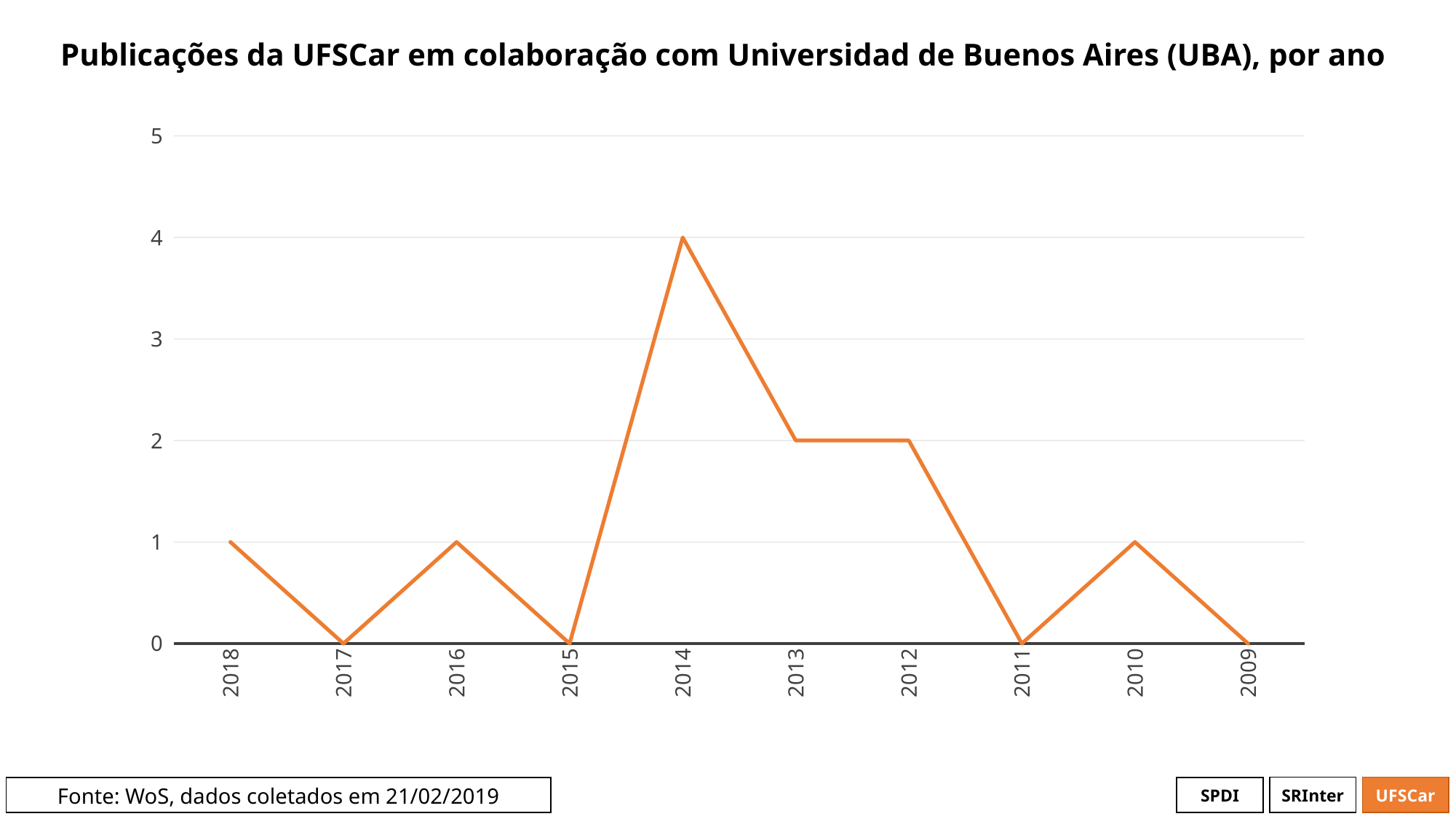
Which year has the highest value? 2014 What is the title of the chart? Publicações da UFSCar em colaboração com Universidad de Buenos Aires (UBA), por ano What is the value for 2014? 4 What is the value for 2011? 0 What is the value for 2018? 1 Does the line rise or fall from 2014 to 2011 (moving right along the x axis)? fall What is the difference between the values for 2014 and 2012? 2 What kind of chart is shown on the slide? line chart Which is larger, the value for 2016 or the value for 2013? 2013 How many years are plotted on the x axis? 10 Is the value for 2014 greater or less than 3? greater What is the value for 2013? 2